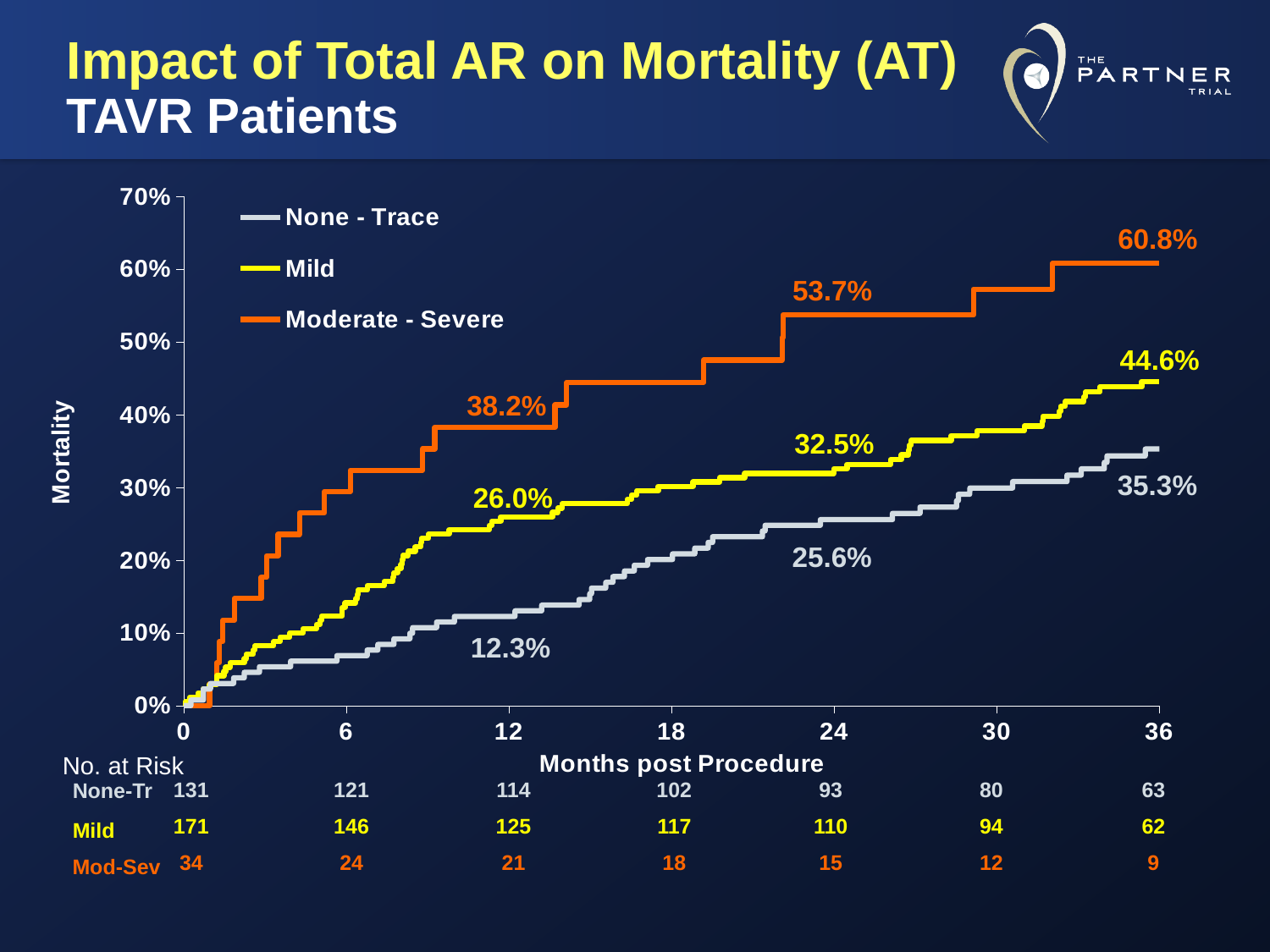
Which group has the highest mortality at 36 months? Moderate - Severe Which group has the lowest mortality at 24 months? None - Trace What is the mortality for the None - Trace group at 12 months? 12.3% Is the mortality for the Mild group at 36 months greater or less than 40%? greater Which is larger at 12 months: the mortality for Mild or for None - Trace? Mild How many series does the legend list? 3 What colour is the line for the Moderate - Severe group? Orange What is the mortality for the Moderate - Severe group at 36 months? 60.8% What kind of chart is shown on the slide? Line chart What is the mortality for the Mild group at 24 months? 32.5% What is the difference between the Moderate - Severe and None - Trace mortality at 36 months? 25.5% Does mortality for the Moderate - Severe group rise or fall as months post procedure increase? Rise